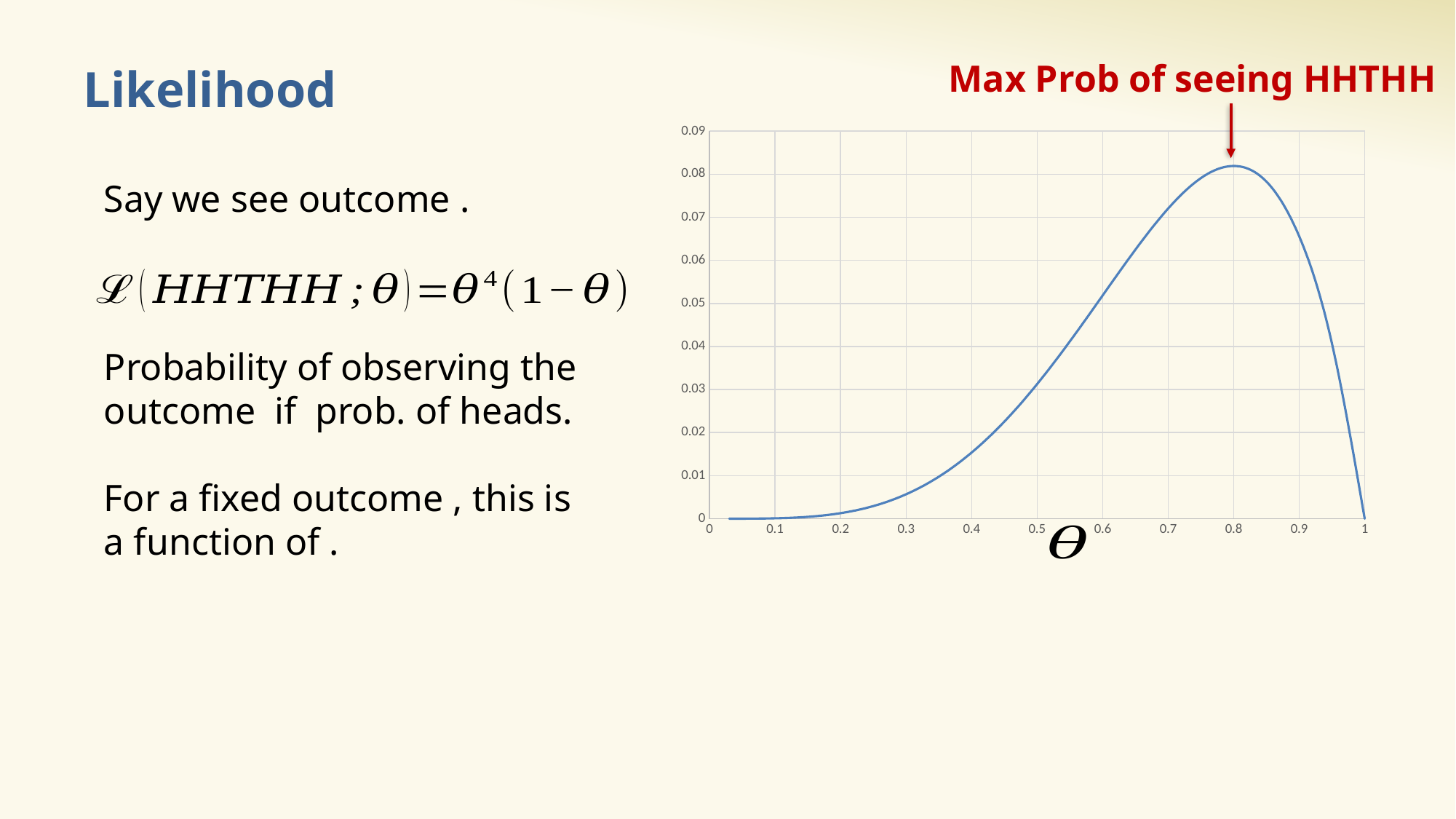
What is the value of the curve at θ = 1? 0 Is the value of the curve at θ = 0.8 greater or less than 0.08? greater What is the label on the x axis of the chart? θ Does the curve rise or fall as θ increases from 0 to 0.8? rise What kind of chart is shown on the slide? line chart Is the value of the curve at θ = 0.7 greater or less than 0.06? greater Is the value of the curve at θ = 0.5 greater or less than 0.04? less What does the red annotation above the peak of the curve say? Max Prob of seeing HHTHH Does the curve rise or fall as θ increases from 0.8 to 1? fall At which value of θ does the curve reach its maximum? 0.8 Which is larger, the value of the curve at θ = 0.6 or at θ = 0.4? θ = 0.6